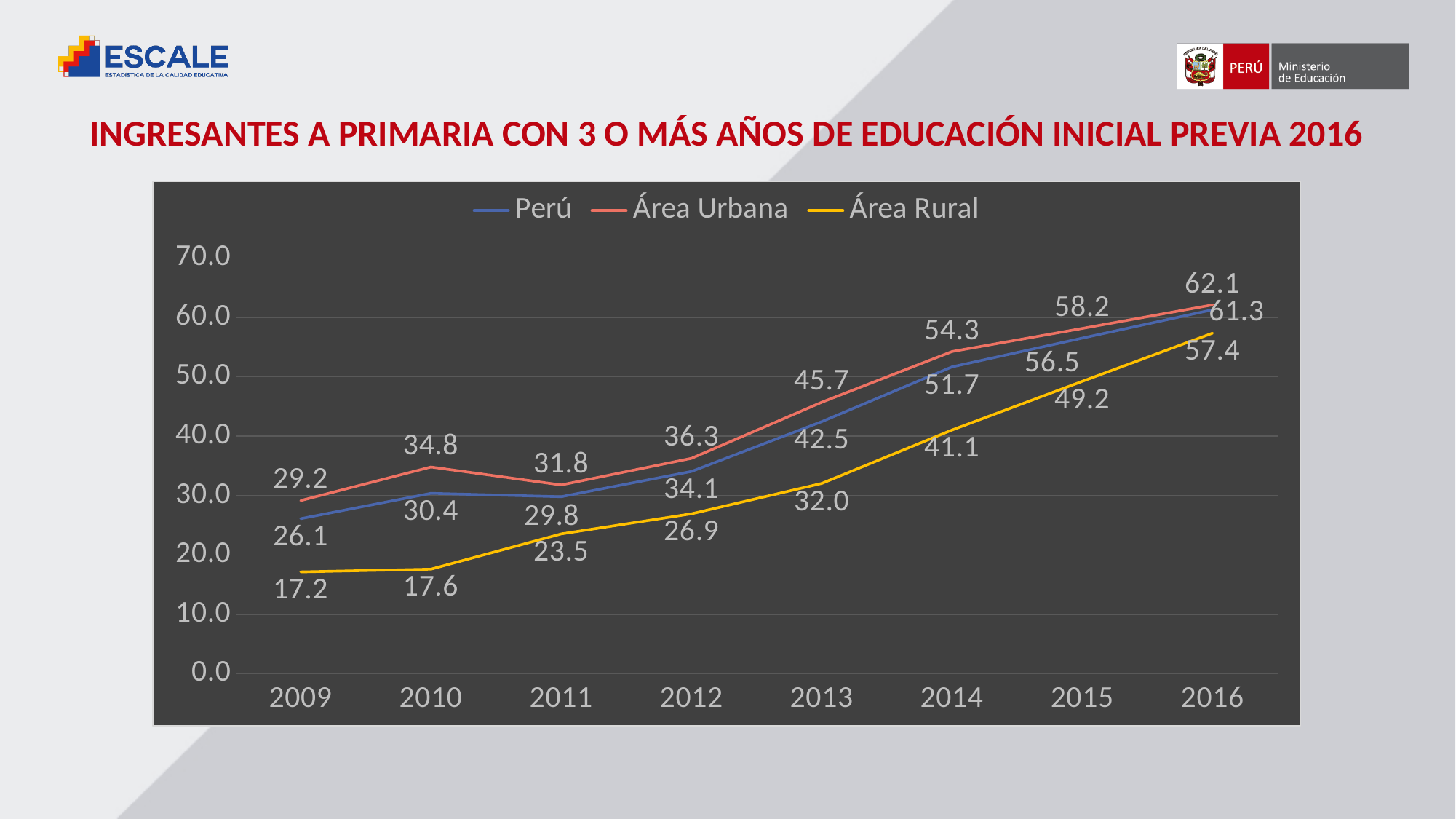
What kind of chart is shown on the slide? Line chart In which year is the Área Rural value highest? 2016 Which is larger in 2011: the Perú value or the Área Urbana value? Área Urbana What is the difference between the Área Urbana and Área Rural values in 2014? 13.2 Is the value for Área Rural in 2015 greater or less than 40.0? greater What is the value for Área Rural in 2009? 17.2 In which year is the Perú value lowest? 2009 What is the value for Perú in 2013? 42.5 What is the value for Área Urbana in 2016? 62.1 How many series does the legend list? 3 How many years are shown on the x axis? 8 Does the Área Rural series rise or fall from 2009 to 2016? Rise